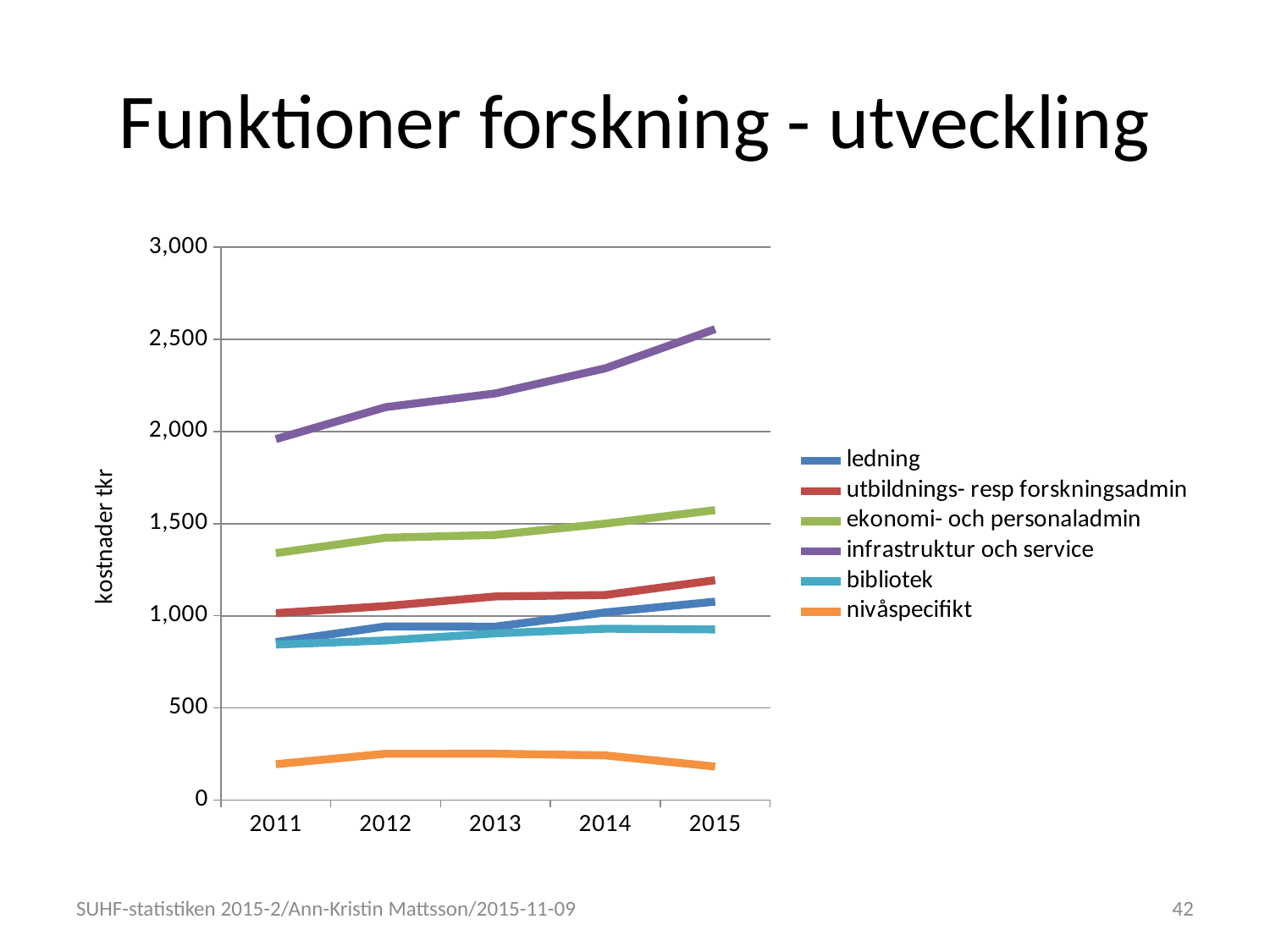
What kind of chart is shown on the slide? line chart Which series has the lowest value in 2013? nivåspecifikt Is the value for infrastruktur och service in 2014 greater or less than 2,000? greater Is the value for ekonomi- och personaladmin in 2015 greater or less than 1,500? greater Does the value for ekonomi- och personaladmin rise or fall from 2011 to 2015? rise Is the value for nivåspecifikt in 2012 greater or less than 500? less Which series has the highest value in 2015? infrastruktur och service What is the label on the y axis of the chart? kostnader tkr Does the value for infrastruktur och service rise or fall from 2011 to 2015? rise In 2015, which is larger: the value for ledning or the value for bibliotek? ledning How many series does the legend list? 6 How many years are shown on the x axis? 5